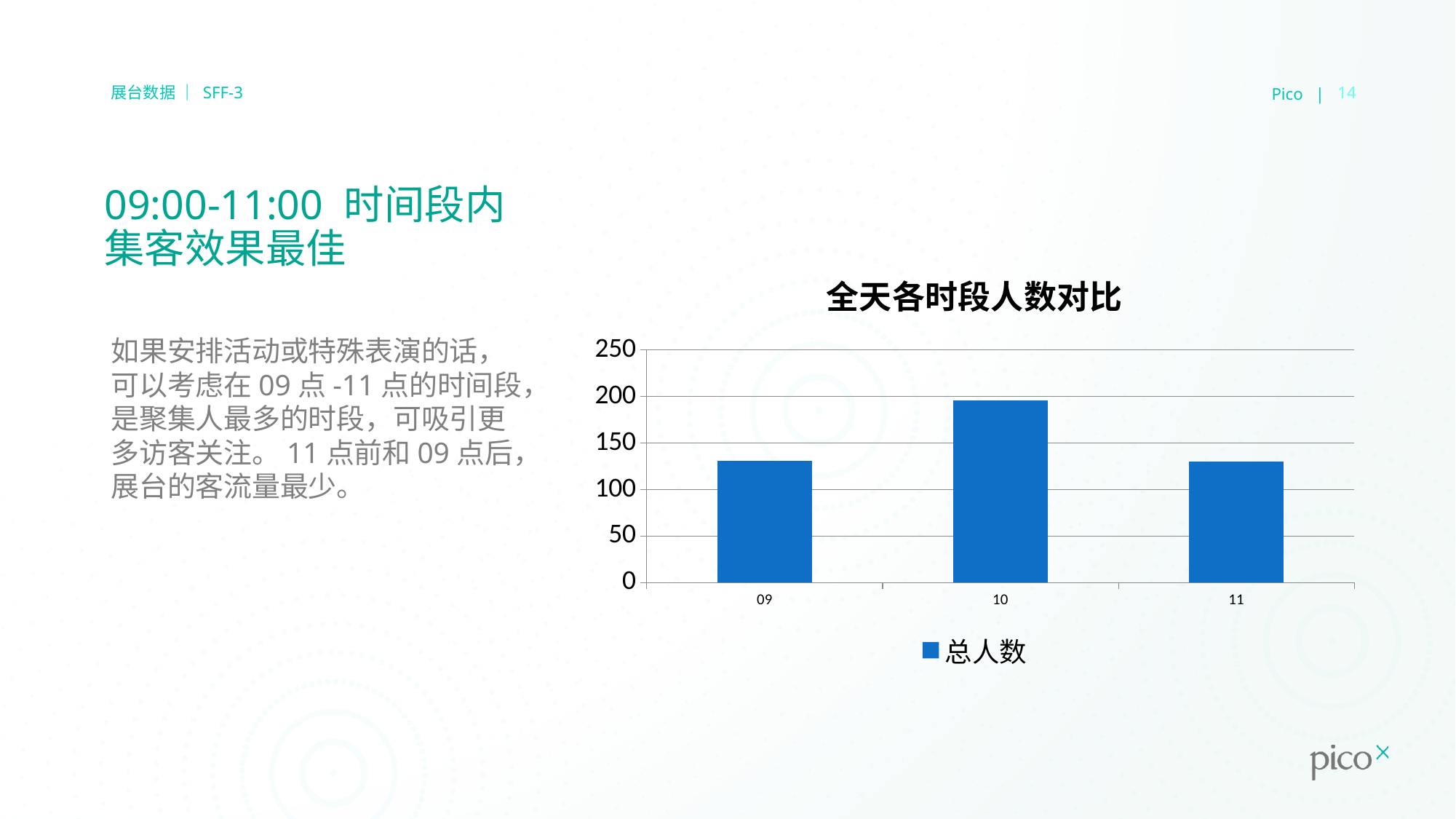
How many series does the chart legend list? 1 What kind of chart is shown on the slide? bar chart Which time slot has the highest 总人数 value? 10 How many categories are shown on the x axis of the chart? 3 Is the 总人数 value for 11 greater or less than 150? less What is the title of the chart? 全天各时段人数对比 What is the name of the series shown in the chart legend? 总人数 Is the 总人数 value for 09 greater or less than 150? less Is the 总人数 value for 09 greater or less than 100? greater Which has a larger 总人数 value, 10 or 11? 10